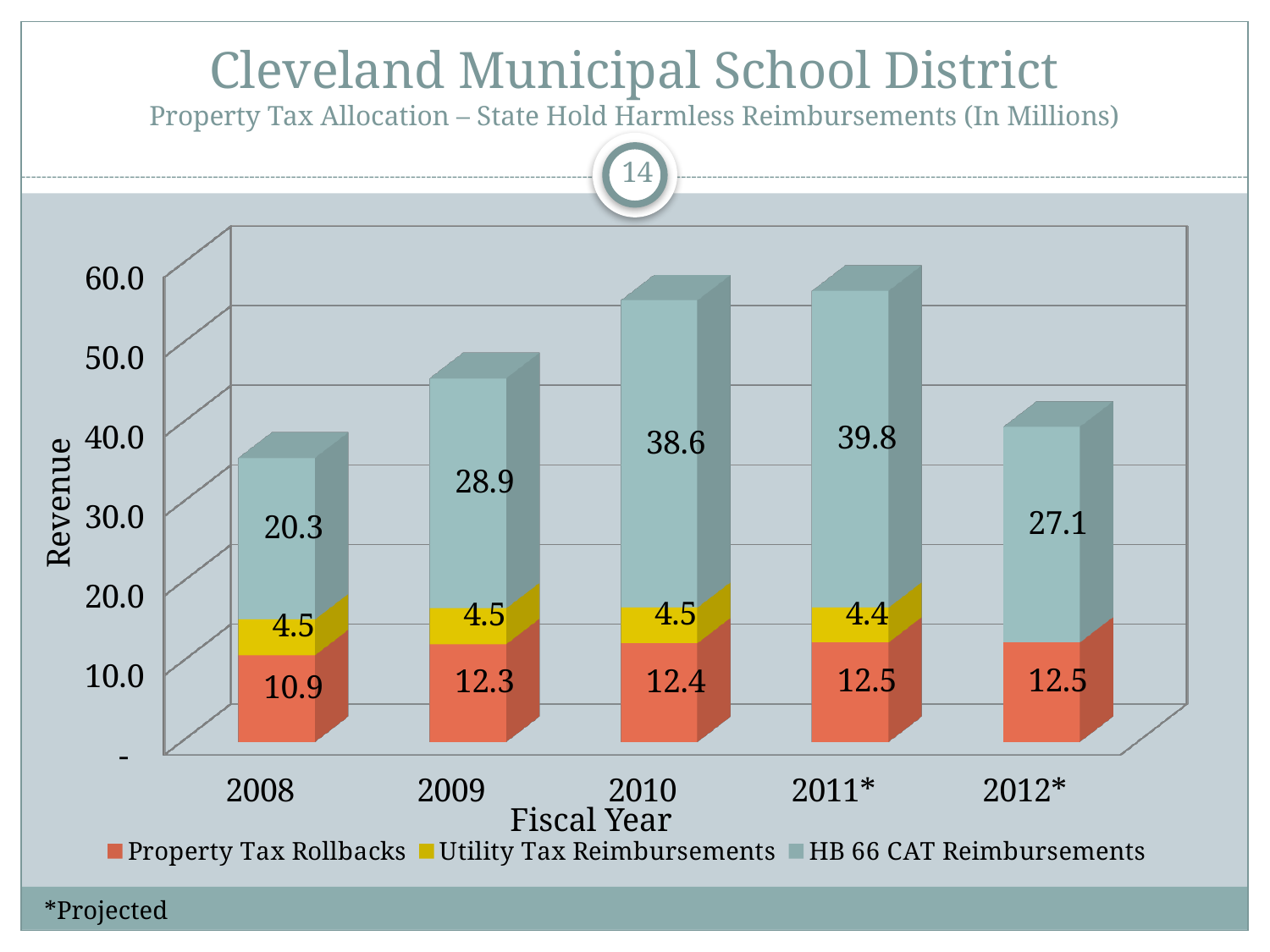
In which fiscal year is the Property Tax Rollbacks value lowest? 2008 How many fiscal years are shown on the x axis? 5 What is the value of Property Tax Rollbacks for fiscal year 2008? 10.9 What kind of chart is shown on the slide? Stacked bar chart What is the value of Utility Tax Reimbursements for fiscal year 2011*? 4.4 What is the value of HB 66 CAT Reimbursements for fiscal year 2010? 38.6 How many series does the legend list? 3 What is the difference between HB 66 CAT Reimbursements in 2011* and in 2008? 19.5 In which fiscal year is the HB 66 CAT Reimbursements value highest? 2011* Does the HB 66 CAT Reimbursements value rise or fall from 2008 to 2011*? Rise Which fiscal year has the larger HB 66 CAT Reimbursements value, 2009 or 2012*? 2009 What is the total of the stacked bar for fiscal year 2010? 55.5